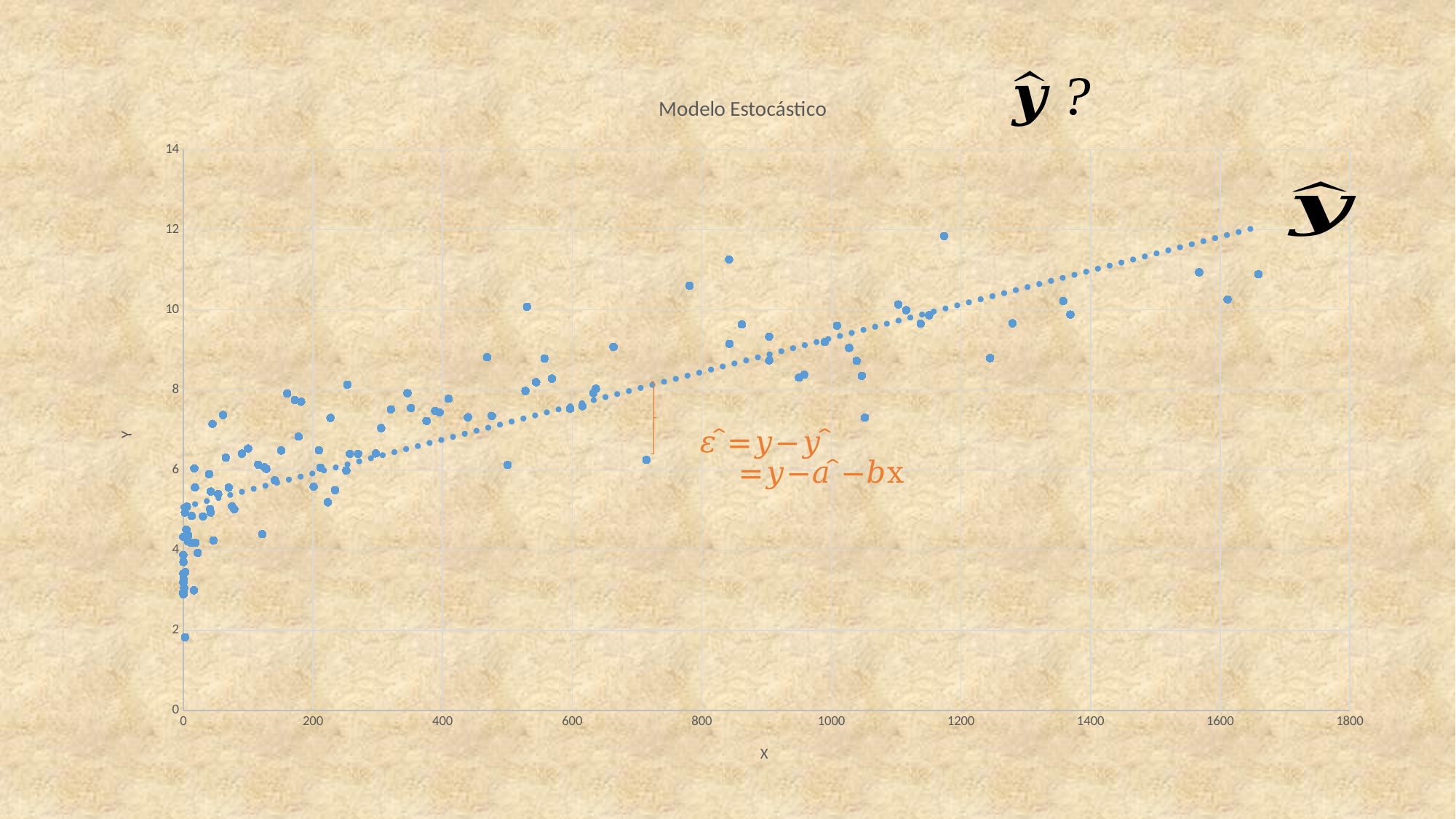
What is the highest tick value shown on the Y axis? 14 Is the Y value of the dotted trend line at X = 200 greater or less than 8? less Do the plotted Y values generally rise or fall as X increases? Rise Is the Y value of the dotted trend line at X = 1600 greater or less than 10? greater Is the Y value of the lowest plotted point greater or less than 2? less What is the title of the chart? Modelo Estocástico What kind of chart is shown on the slide? Scatter plot Does the dotted trend line slope upward or downward from left to right? Upward What is the highest tick value shown on the X axis? 1800 What is the label of the horizontal axis of the chart? X